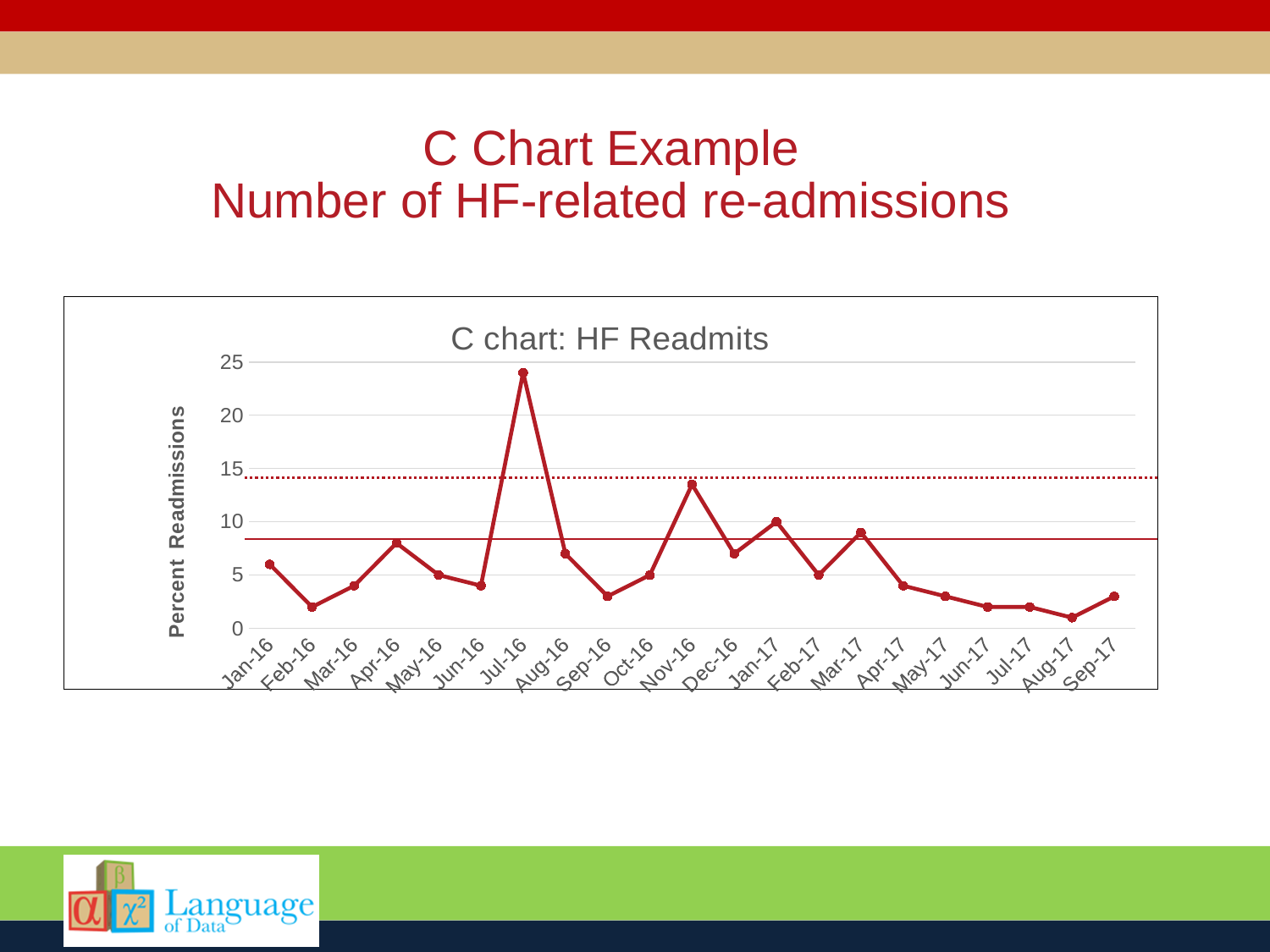
What kind of chart is shown on the slide? line chart How many months are plotted along the x axis? 21 Is the value for Nov-16 greater or less than 10? greater What is the title of the chart? C chart: HF Readmits What is the label on the vertical axis of the chart? Percent Readmissions Is the value for Jul-16 greater or less than 20? greater Is the value for Sep-17 greater or less than 5? less Which is larger, the value for Jul-16 or the value for Nov-16? Jul-16 Which month has the highest value on the chart? Jul-16 Which month has the lowest value on the chart? Aug-17 Do the values rise or fall from Mar-17 to Aug-17? fall